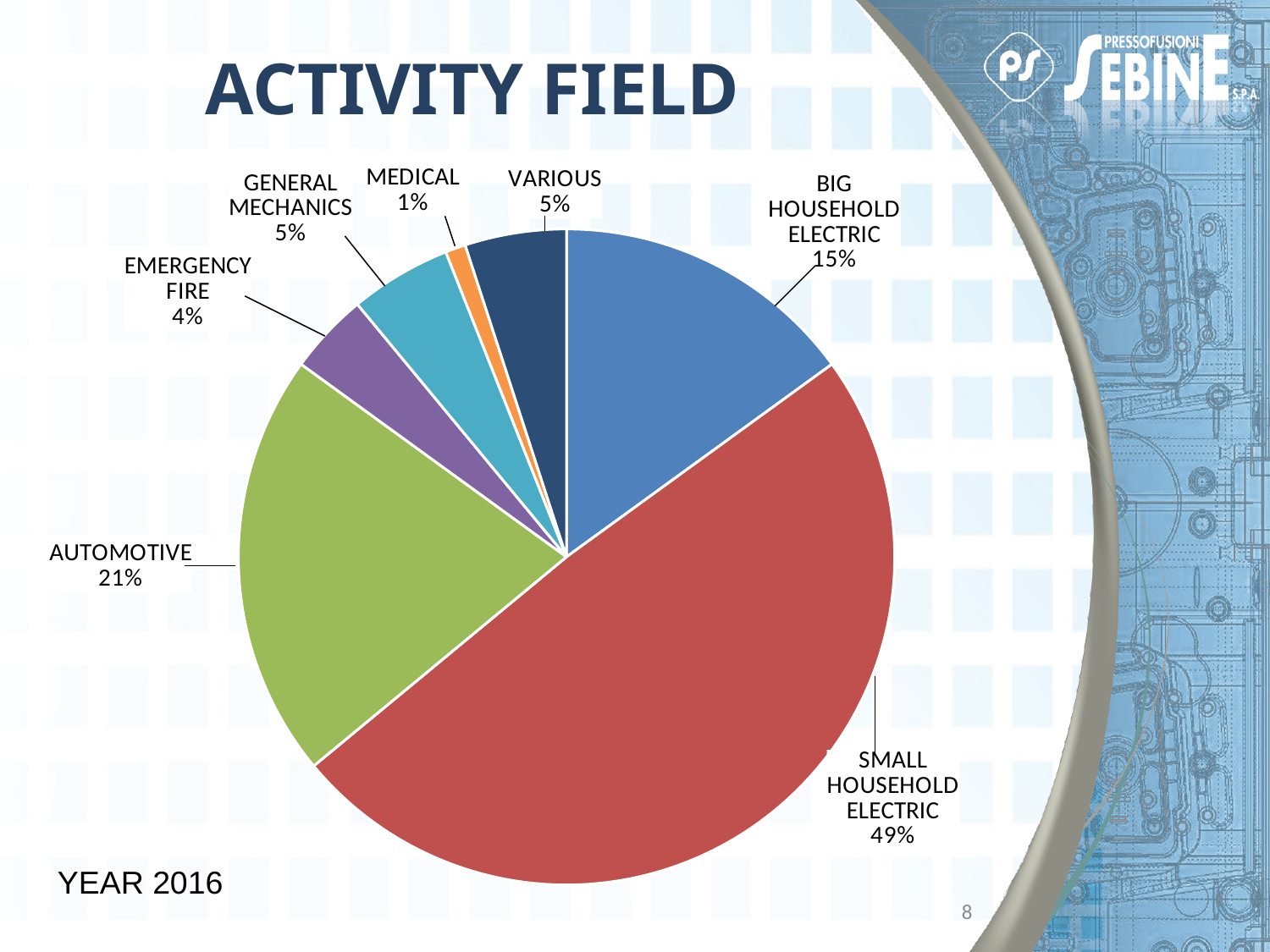
Which is larger, the share for BIG HOUSEHOLD ELECTRIC or the share for GENERAL MECHANICS? BIG HOUSEHOLD ELECTRIC What kind of chart is shown on the slide? pie chart What is the title of the slide containing the chart? ACTIVITY FIELD What is the difference between the shares of SMALL HOUSEHOLD ELECTRIC and AUTOMOTIVE? 28% Which category has the largest slice of the pie? SMALL HOUSEHOLD ELECTRIC What share of the pie does AUTOMOTIVE have? 21% How many slices does the pie chart have? 7 What is the value shown for EMERGENCY FIRE? 4% What share of the pie does BIG HOUSEHOLD ELECTRIC have? 15% What share of the pie does SMALL HOUSEHOLD ELECTRIC have? 49% Which category has the smallest slice of the pie? MEDICAL What is the value shown for MEDICAL? 1%